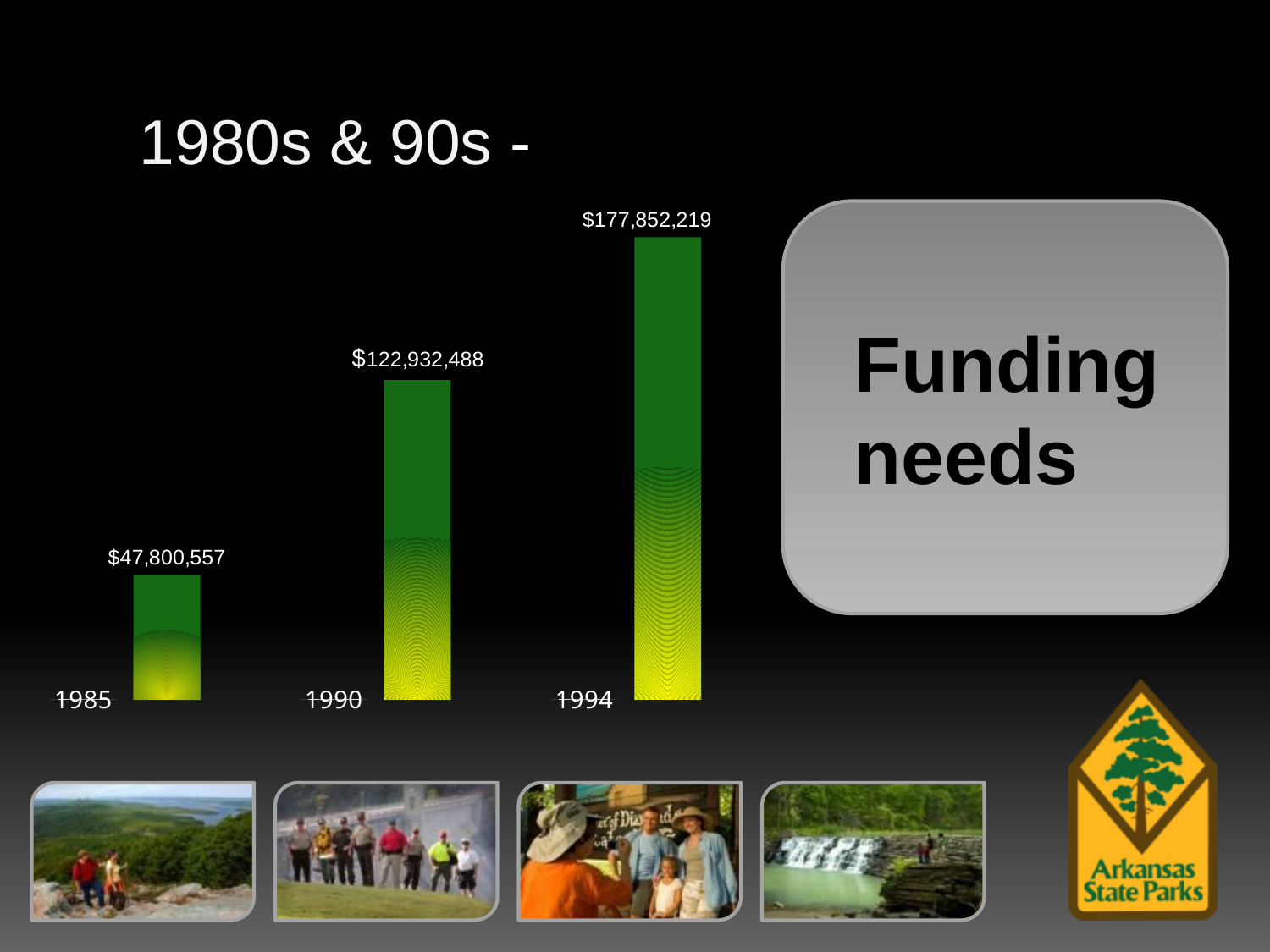
Which year has the lowest value? 1985 What is the value shown for 1985? $47,800,557 What is the difference between the values for 1990 and 1985? $75,131,931 What is the value shown for 1990? $122,932,488 What is the value shown for 1994? $177,852,219 What kind of chart is shown on the slide? Bar chart What is the difference between the values for 1994 and 1985? $130,051,662 What is the difference between the values for 1994 and 1990? $54,919,731 Which is larger, the value for 1990 or the value for 1994? 1994 Which year has the highest value? 1994 How many years are plotted in the chart? 3 Do the values rise or fall from 1985 to 1994? Rise